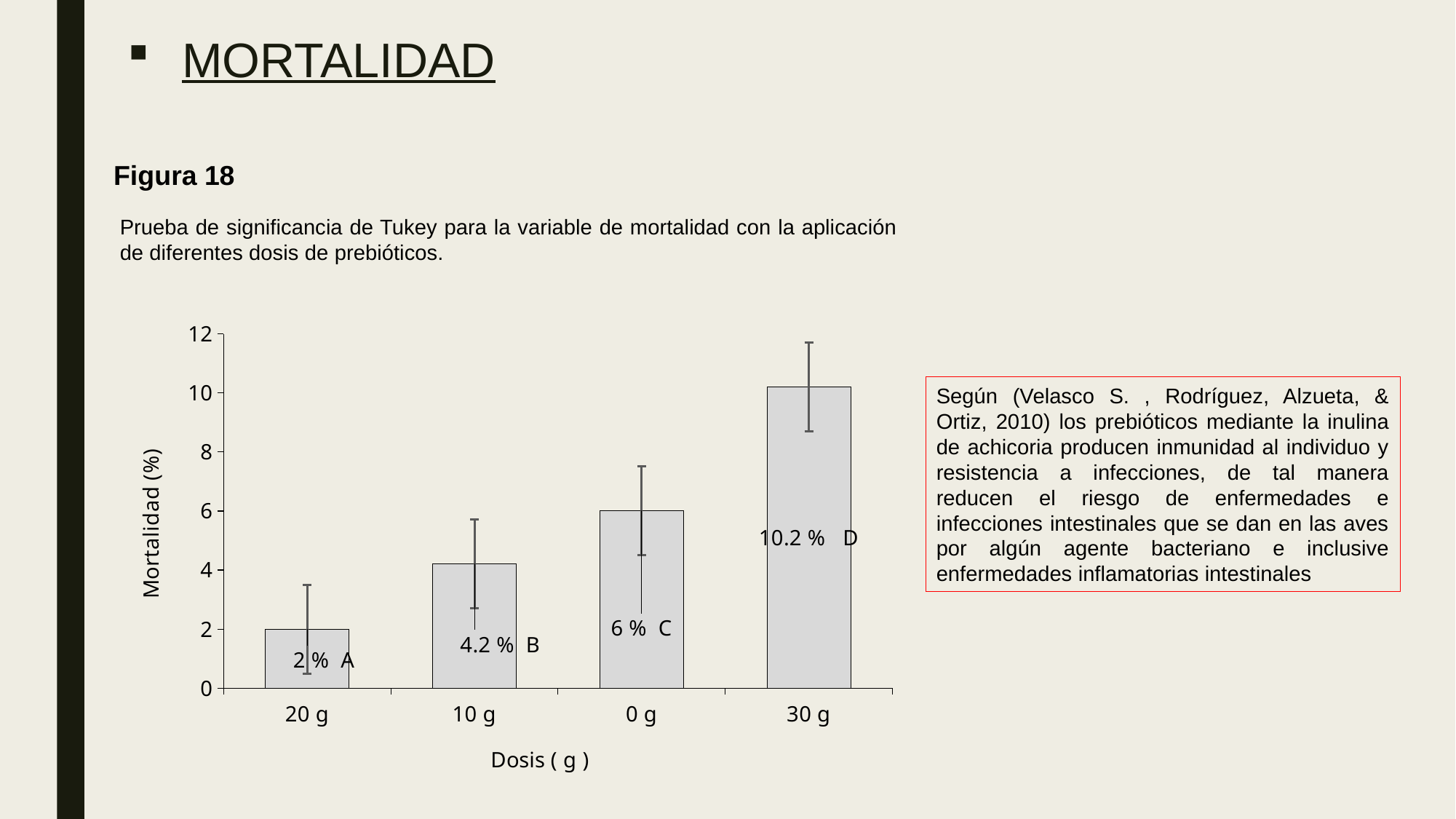
What is the mortality value for the 20 g dose? 2 % Which dose has the highest mortality? 30 g What is the label of the y axis? Mortalidad (%) How many dose categories are shown on the x axis? 4 What kind of chart is shown on the slide? bar chart Is the mortality value for the 30 g dose greater or less than 8? greater What is the mortality value for the 0 g dose? 6 % What is the difference in mortality between the 30 g dose and the 0 g dose? 4.2 % What is the mortality value for the 30 g dose? 10.2 % What is the mortality value for the 10 g dose? 4.2 % Which dose has the lowest mortality? 20 g Which has higher mortality, the 10 g dose or the 0 g dose? 0 g